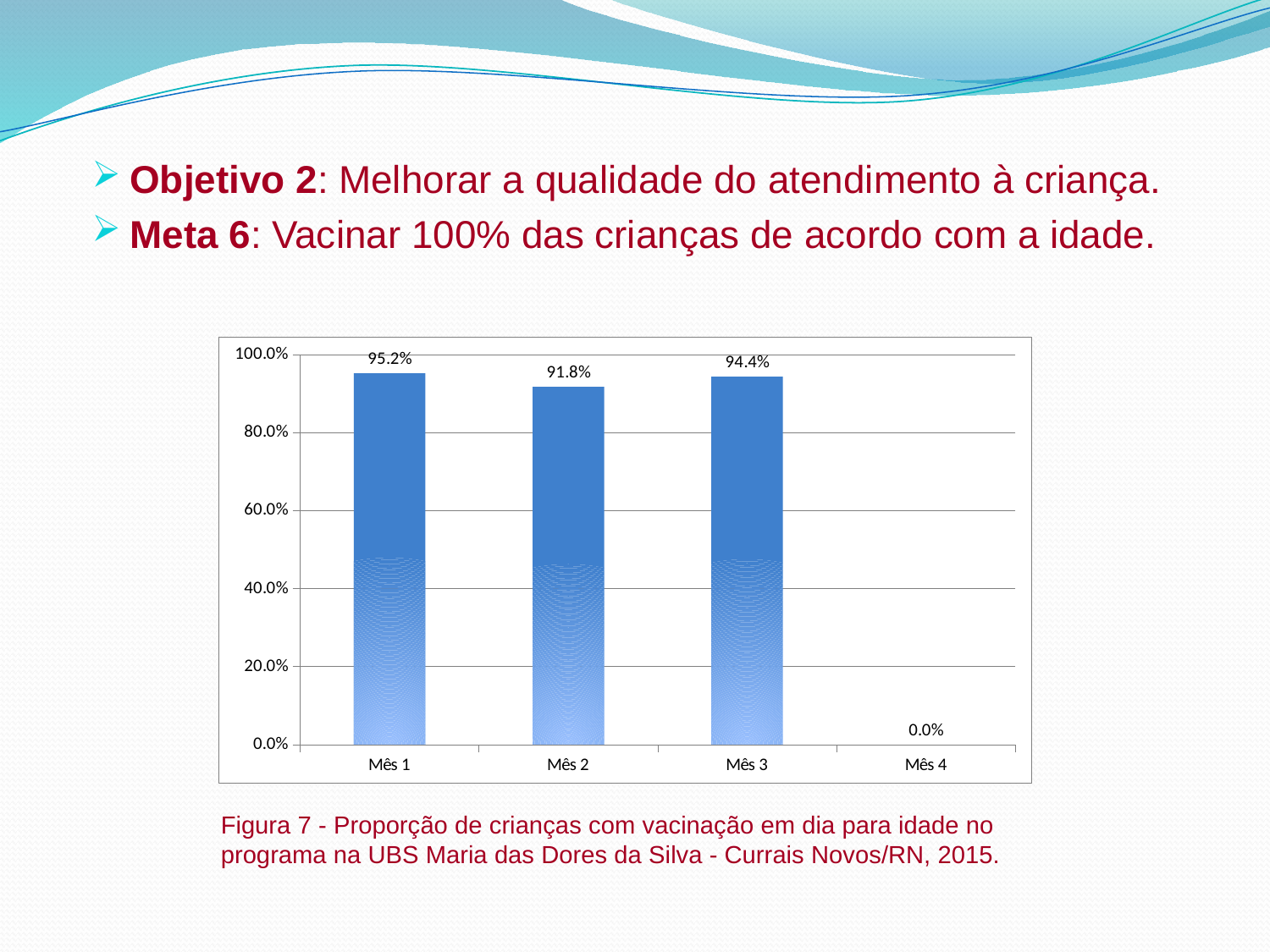
What is the value for Mês 4? 0.0% Is the value for Mês 2 greater or less than 80.0%? greater Which month has the lowest value? Mês 4 What is the figure number given in the caption below the chart? Figura 7 How many months are shown on the x axis? 4 What is the value for Mês 2? 91.8% What kind of chart is shown on the slide? bar chart What is the difference between the values for Mês 1 and Mês 2? 3.4% What is the value for Mês 1? 95.2% What is the value for Mês 3? 94.4% Which is larger, the value for Mês 2 or Mês 3? Mês 3 Which month has the highest value? Mês 1